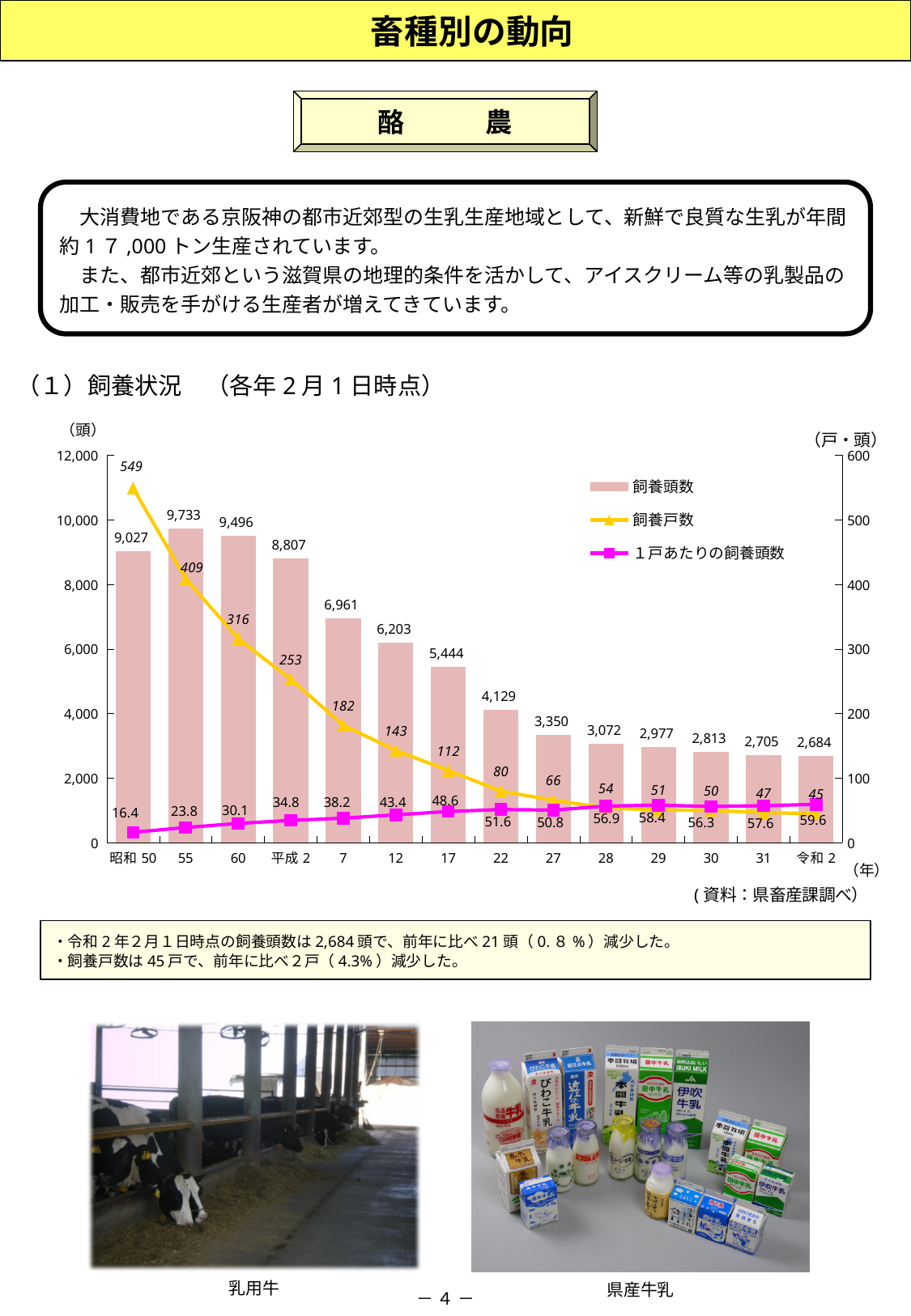
飼養戸数の昭和50年の値はいくつですか？ 549 飼養戸数が最も少ない年はどれですか？ 令和2 凡例には何個の系列が示されていますか？ 3 飼養頭数は平成2年から令和2年にかけて増加していますか、減少していますか？ 減少 1戸あたりの飼養頭数の平成22年の値はいくつですか？ 51.6 飼養頭数の令和2年の値はいくつですか？ 2,684 飼養戸数の平成31年と令和2年の差はいくつですか？ 2 1戸あたりの飼養頭数が最も多い年はどれですか？ 令和2 飼養頭数は昭和60年と平成2年のどちらが多いですか？ 60 このグラフの横軸には何個の年が示されていますか？ 14 飼養頭数の平成31年と令和2年の差はいくつですか？ 21 飼養頭数が最も多い年はどれですか？ 55